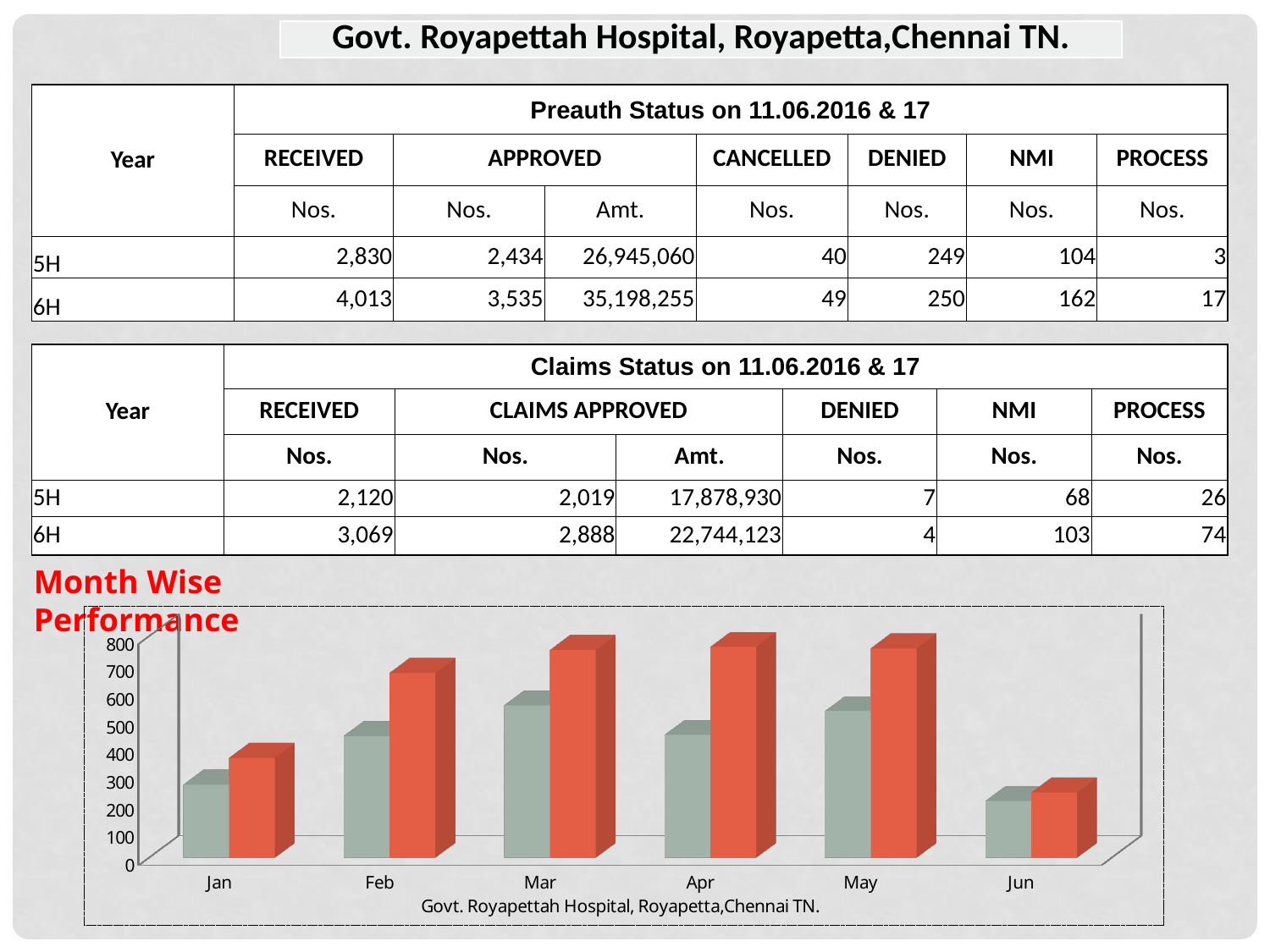
What text appears below the x axis of the Month Wise Performance chart? Govt. Royapettah Hospital, Royapetta,Chennai TN. In the Month Wise Performance chart, is the grey bar for Jan greater or less than 300? less How many months are shown on the x axis of the Month Wise Performance chart? 6 In the Month Wise Performance chart, is the grey bar for Apr greater or less than 500? less In the Month Wise Performance chart, which is larger, the grey bar for Mar or the grey bar for Jun? the grey bar for Mar In the Month Wise Performance chart, which month has the lowest grey bar? Jun What kind of chart is shown at the bottom of the slide? bar chart In the Month Wise Performance chart, which is larger for Feb, the grey bar or the orange bar? the orange bar In the Month Wise Performance chart, which month has the lowest orange bar? Jun In the Month Wise Performance chart, is the orange bar for Jun greater or less than 300? less